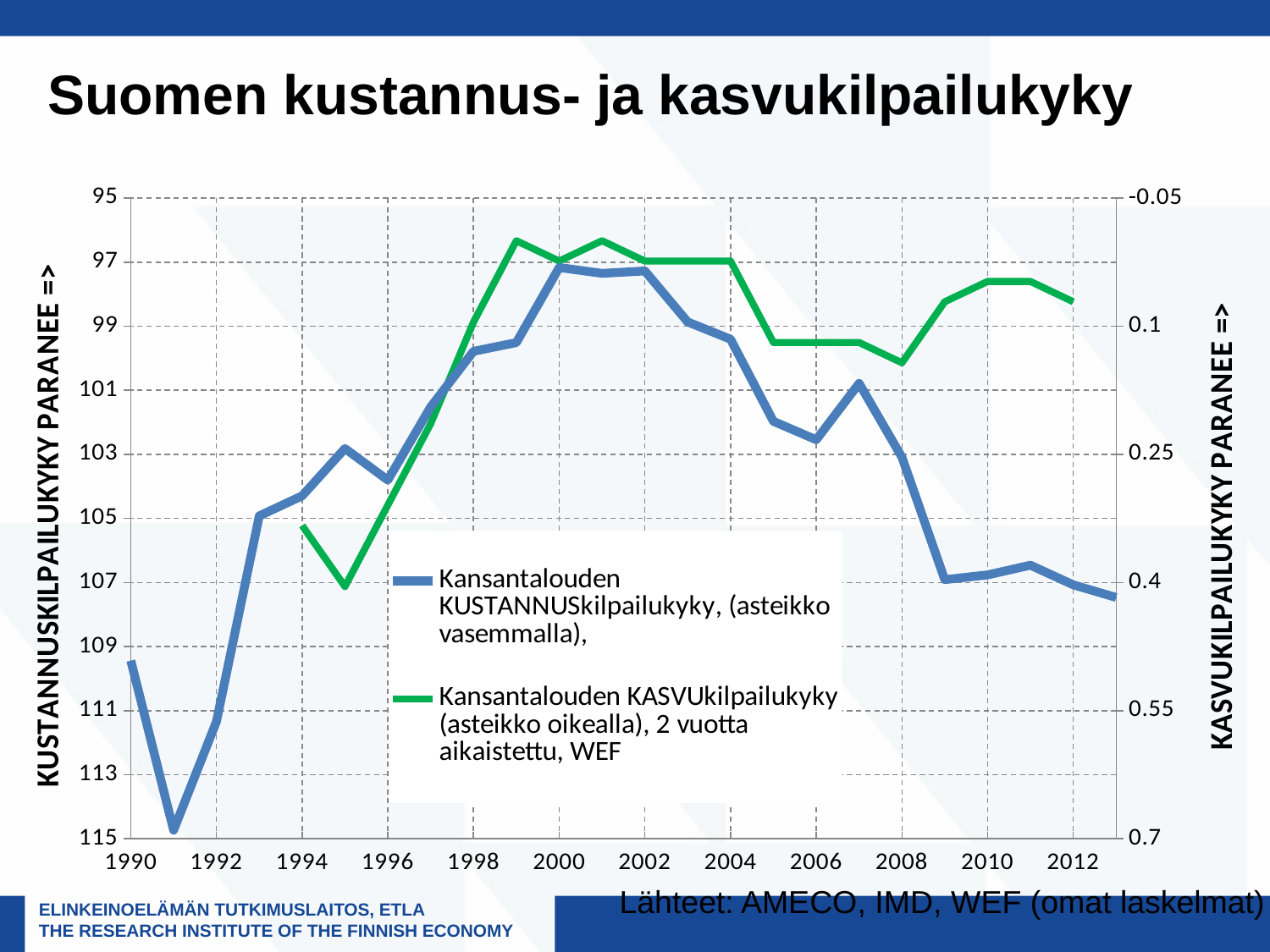
What colour is the line for Kansantalouden KASVUkilpailukyky? green Does the blue Kansantalouden KUSTANNUSkilpailukyky line rise or fall in numeric value on the left axis from 2008 to 2009? rise Is the value of the blue Kansantalouden KUSTANNUSkilpailukyky line in 2000 greater or less than 99 on the left axis? less What kind of chart is shown on the slide? line chart How many series does the legend list? 2 Is the value of the green Kansantalouden KASVUkilpailukyky line in 1995 greater or less than 0.25 on the right axis? greater Is the value of the blue Kansantalouden KUSTANNUSkilpailukyky line in 1991 greater or less than 113 on the left axis? greater What is the title of the chart? Suomen kustannus- ja kasvukilpailukyky How many year labels are shown on the x axis? 12 Does the blue Kansantalouden KUSTANNUSkilpailukyky line rise or fall in numeric value on the left axis from 1991 to 2000? fall